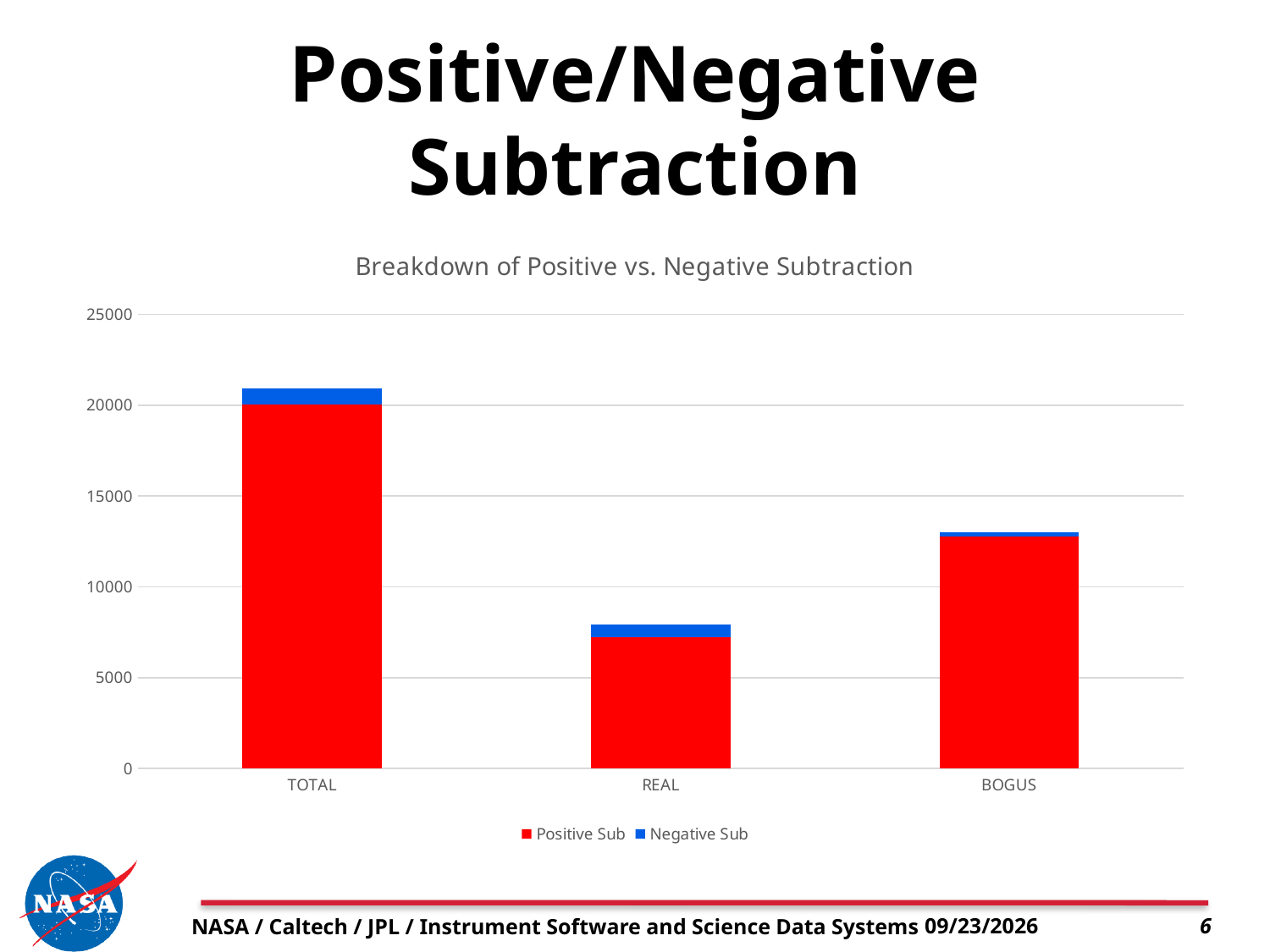
Which category has the shortest stacked bar? REAL Is the total height of the REAL bar greater or less than 10000? less How many categories are shown on the x axis? 3 What is the title of the chart? Breakdown of Positive vs. Negative Subtraction Which stacked bar is taller, REAL or BOGUS? BOGUS Is the total height of the TOTAL bar greater or less than 20000? greater How many series does the legend list? 2 Is the total height of the BOGUS bar greater or less than 15000? less What kind of chart is shown on the slide? bar chart Which category has the tallest stacked bar? TOTAL Which series is shown in red? Positive Sub